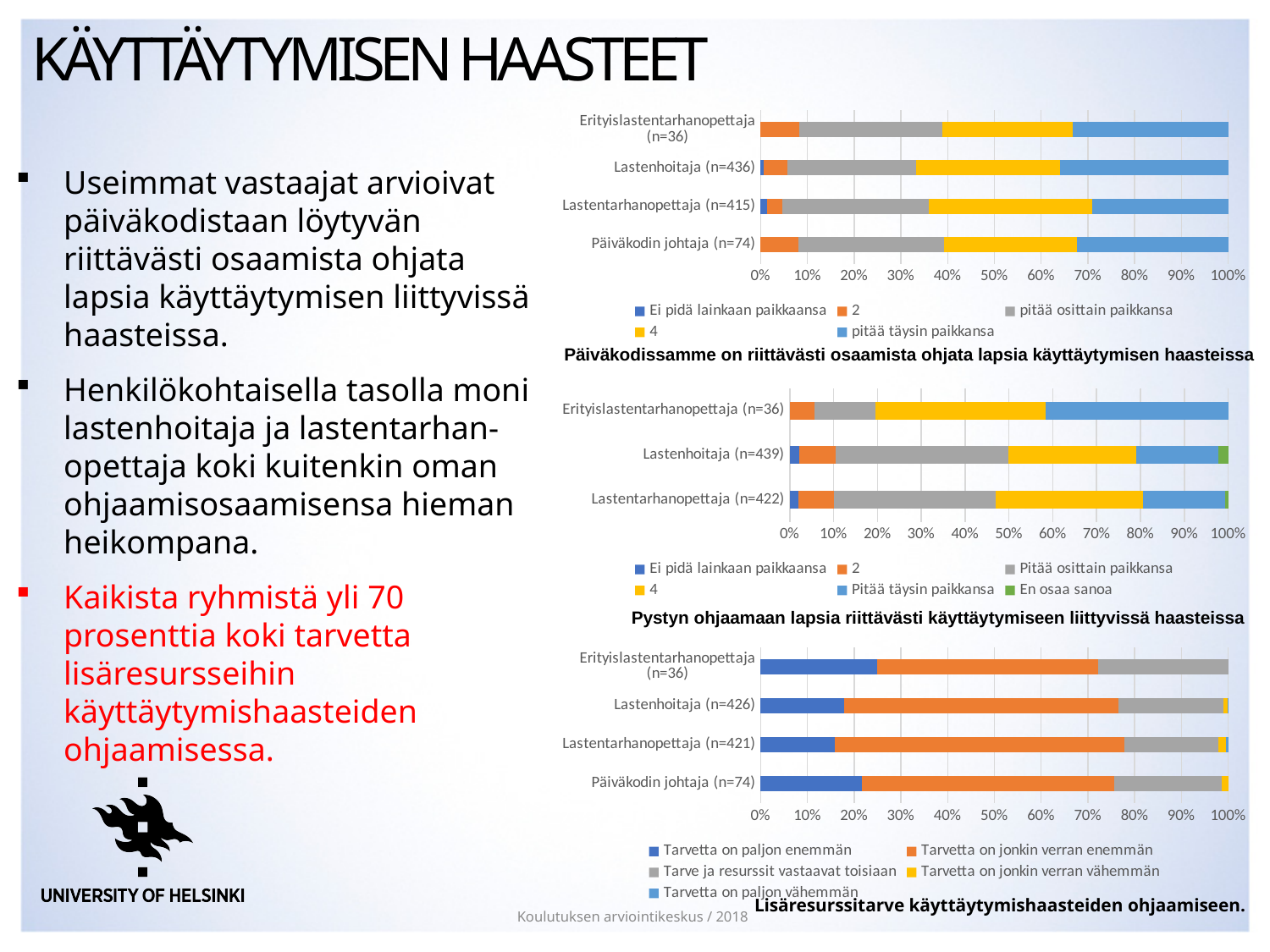
In the bottom chart 'Lisäresurssitarve käyttäytymishaasteiden ohjaamiseen', is the 'Tarvetta on paljon enemmän' share for Erityislastentarhanopettaja (n=36) greater or less than 20%? greater How many respondent groups are shown in the top chart 'Päiväkodissamme on riittävästi osaamista ohjata lapsia käyttäytymisen haasteissa'? 4 How many series does the legend of the top chart 'Päiväkodissamme on riittävästi osaamista ohjata lapsia käyttäytymisen haasteissa' list? 5 How many respondent groups are shown in the middle chart 'Pystyn ohjaamaan lapsia riittävästi käyttäytymiseen liittyvissä haasteissa'? 3 How many series does the legend of the bottom chart 'Lisäresurssitarve käyttäytymishaasteiden ohjaamiseen' list? 5 In the bottom chart 'Lisäresurssitarve käyttäytymishaasteiden ohjaamiseen', is the 'Tarvetta on paljon enemmän' share for Lastentarhanopettaja (n=421) greater or less than 20%? less How many series does the legend of the middle chart 'Pystyn ohjaamaan lapsia riittävästi käyttäytymiseen liittyvissä haasteissa' list? 6 In the bottom chart 'Lisäresurssitarve käyttäytymishaasteiden ohjaamiseen', which group has the larger 'Tarvetta on paljon enemmän' share: Erityislastentarhanopettaja (n=36) or Lastentarhanopettaja (n=421)? Erityislastentarhanopettaja (n=36) In the top chart 'Päiväkodissamme on riittävästi osaamista ohjata lapsia käyttäytymisen haasteissa', is the 'pitää osittain paikkansa' share for Lastenhoitaja (n=436) greater or less than 20%? greater In the middle chart 'Pystyn ohjaamaan lapsia riittävästi käyttäytymiseen liittyvissä haasteissa', which legend entry is shown in green? En osaa sanoa What is the title of the bottom chart on the slide? Lisäresurssitarve käyttäytymishaasteiden ohjaamiseen. What kind of chart is the top chart titled 'Päiväkodissamme on riittävästi osaamista ohjata lapsia käyttäytymisen haasteissa'? Stacked bar chart